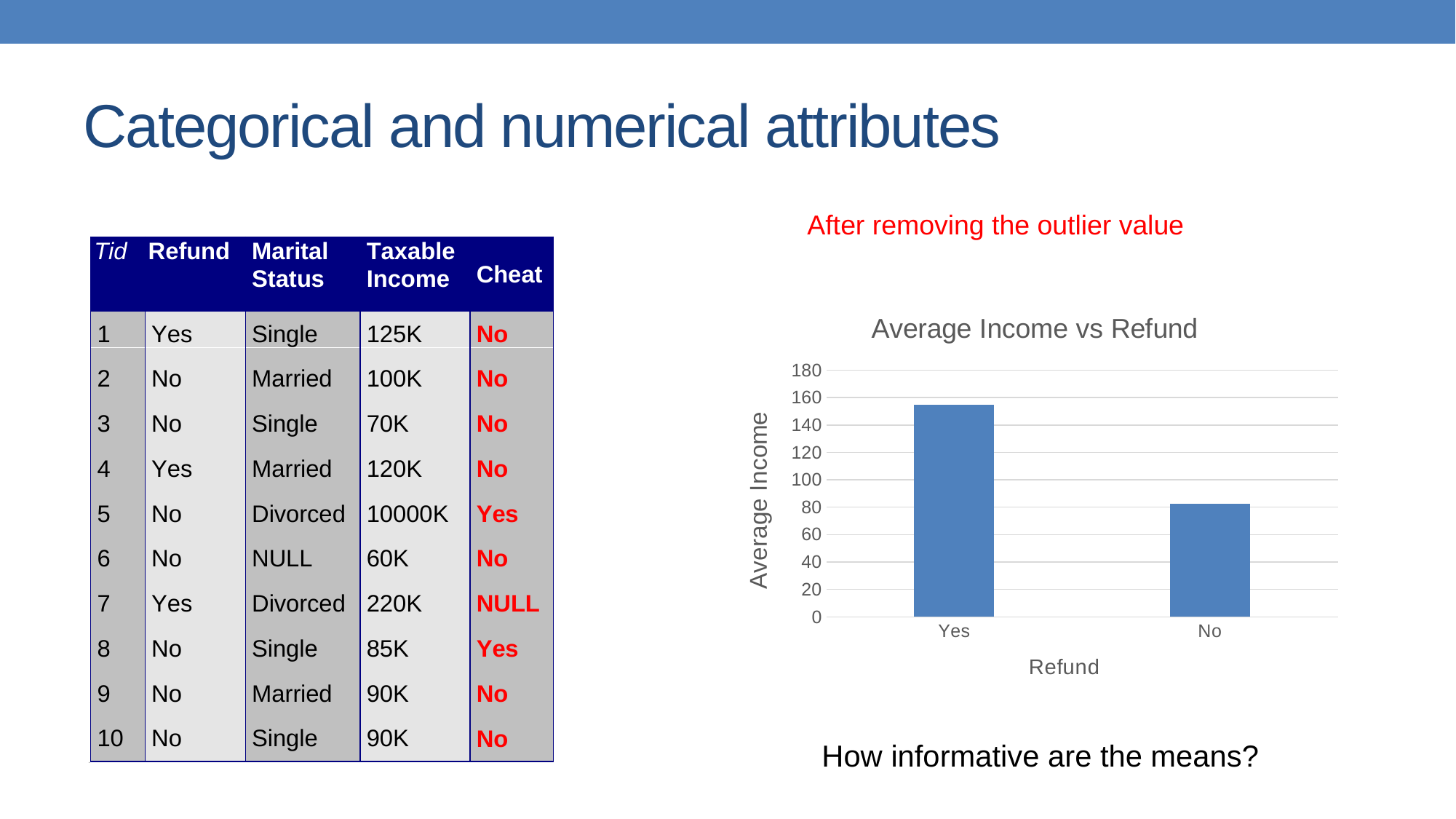
Do the bar values rise or fall moving from Yes to No along the x axis? fall Is the average income for Refund = Yes greater or less than 160? less Which has a larger average income, Refund = Yes or Refund = No? Yes How many categories are shown on the x axis of the Average Income vs Refund chart? 2 Is the average income for Refund = No greater or less than 60? greater Which Refund category has the lowest average income? No Is the average income for Refund = Yes greater or less than 140? greater What is the label on the y axis of the chart? Average Income Which Refund category has the highest average income? Yes What kind of chart is shown on the slide? bar chart What is the title of the chart? Average Income vs Refund